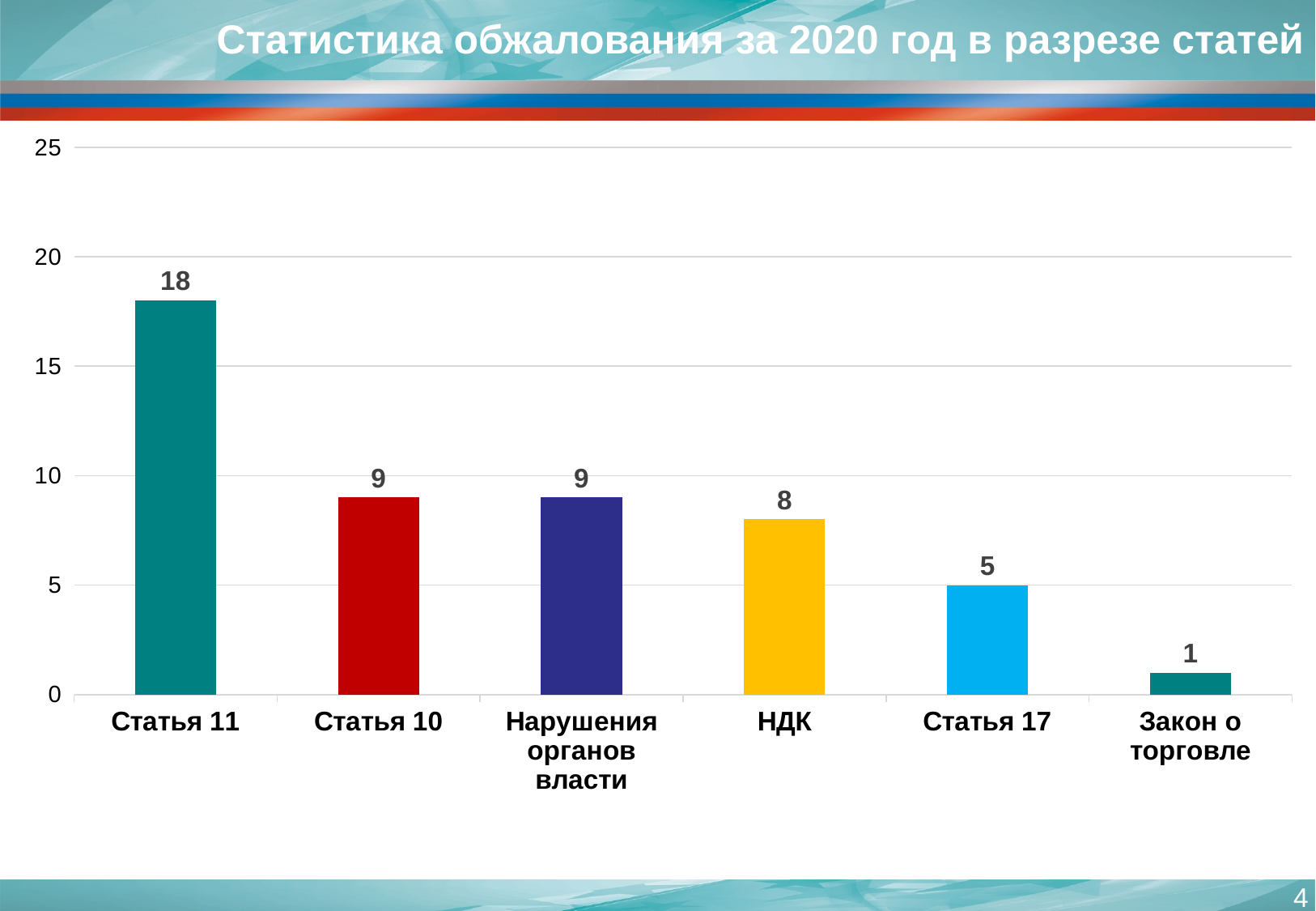
What is the title of the slide? Статистика обжалования за 2020 год в разрезе статей What is the difference between the values for НДК and Статья 17? 3 Which category has the highest value? Статья 11 What is the value for Статья 17? 5 What is the value for Закон о торговле? 1 Which category has the lowest value? Закон о торговле What kind of chart is shown on the slide? Bar chart What is the value for НДК? 8 What is the difference between the values for Статья 11 and Статья 10? 9 What is the value for Статья 11? 18 Which is larger, the value for НДК or the value for Статья 17? НДК How many categories are shown on the chart? 6